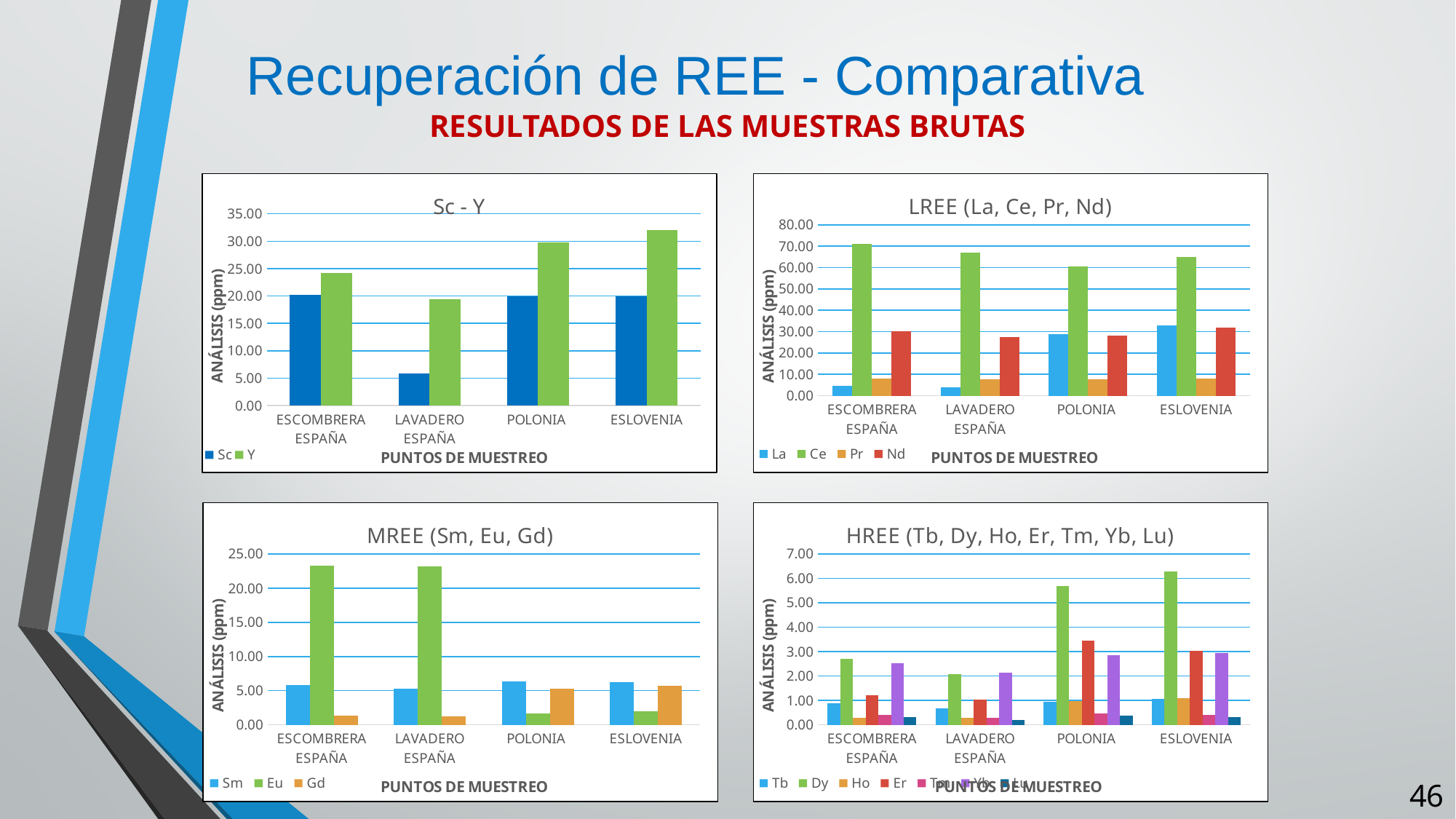
How many series does the legend of the HREE (Tb, Dy, Ho, Er, Tm, Yb, Lu) chart list? 7 In the LREE (La, Ce, Pr, Nd) chart, which sampling point has the highest Ce value? ESCOMBRERA ESPAÑA In the Sc - Y chart, is the Y value for POLONIA greater or less than 25.00? greater What kind of chart is the MREE (Sm, Eu, Gd) chart? Bar chart In the HREE (Tb, Dy, Ho, Er, Tm, Yb, Lu) chart, which sampling point has the highest Dy value? ESLOVENIA In the Sc - Y chart, which sampling point has the lowest Sc value? LAVADERO ESPAÑA In the LREE (La, Ce, Pr, Nd) chart, which is larger for POLONIA, the La value or the Ce value? Ce In the LREE (La, Ce, Pr, Nd) chart, is the La value for ESLOVENIA greater or less than 30.00? greater In the MREE (Sm, Eu, Gd) chart, is the Eu value for ESCOMBRERA ESPAÑA greater or less than 20.00? greater In the MREE (Sm, Eu, Gd) chart, which sampling point has the lowest Eu value? POLONIA In the Sc - Y chart, which sampling point has the highest Y value? ESLOVENIA